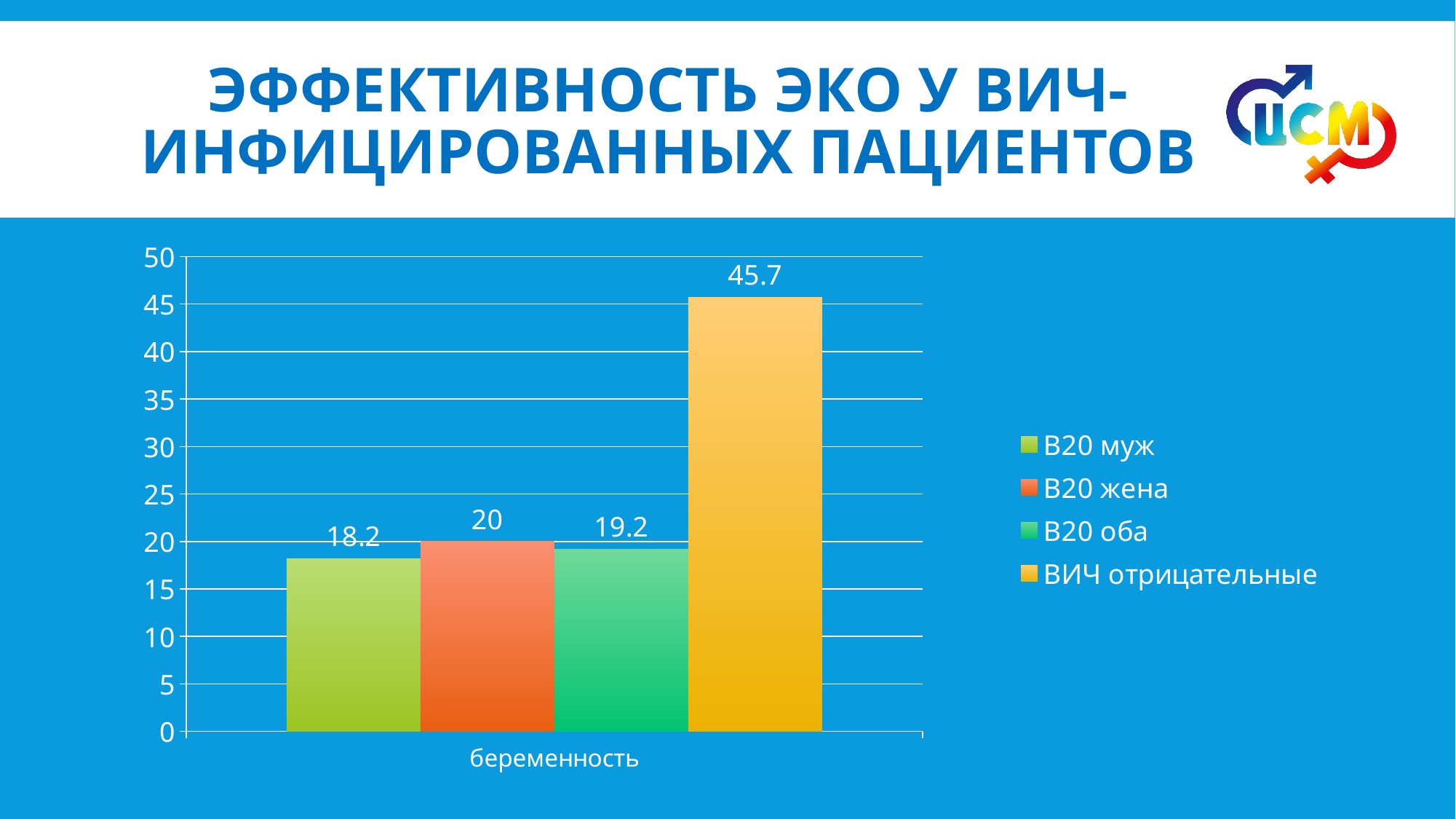
Which series has the highest value? ВИЧ отрицательные Is the value for "ВИЧ отрицательные" greater or less than 40? greater What is the value for the series "В20 жена"? 20 What is the value for the series "ВИЧ отрицательные"? 45.7 How many series does the legend list? 4 Which is larger, the value for "В20 оба" or the value for "В20 муж"? В20 оба What is the value for the series "В20 оба"? 19.2 What is the value for the series "В20 муж" in the "беременность" category? 18.2 What is the category label on the x axis? беременность Which series has the lowest value? В20 муж What is the difference between the values for "ВИЧ отрицательные" and "В20 жена"? 25.7 What kind of chart is shown on the slide? bar chart